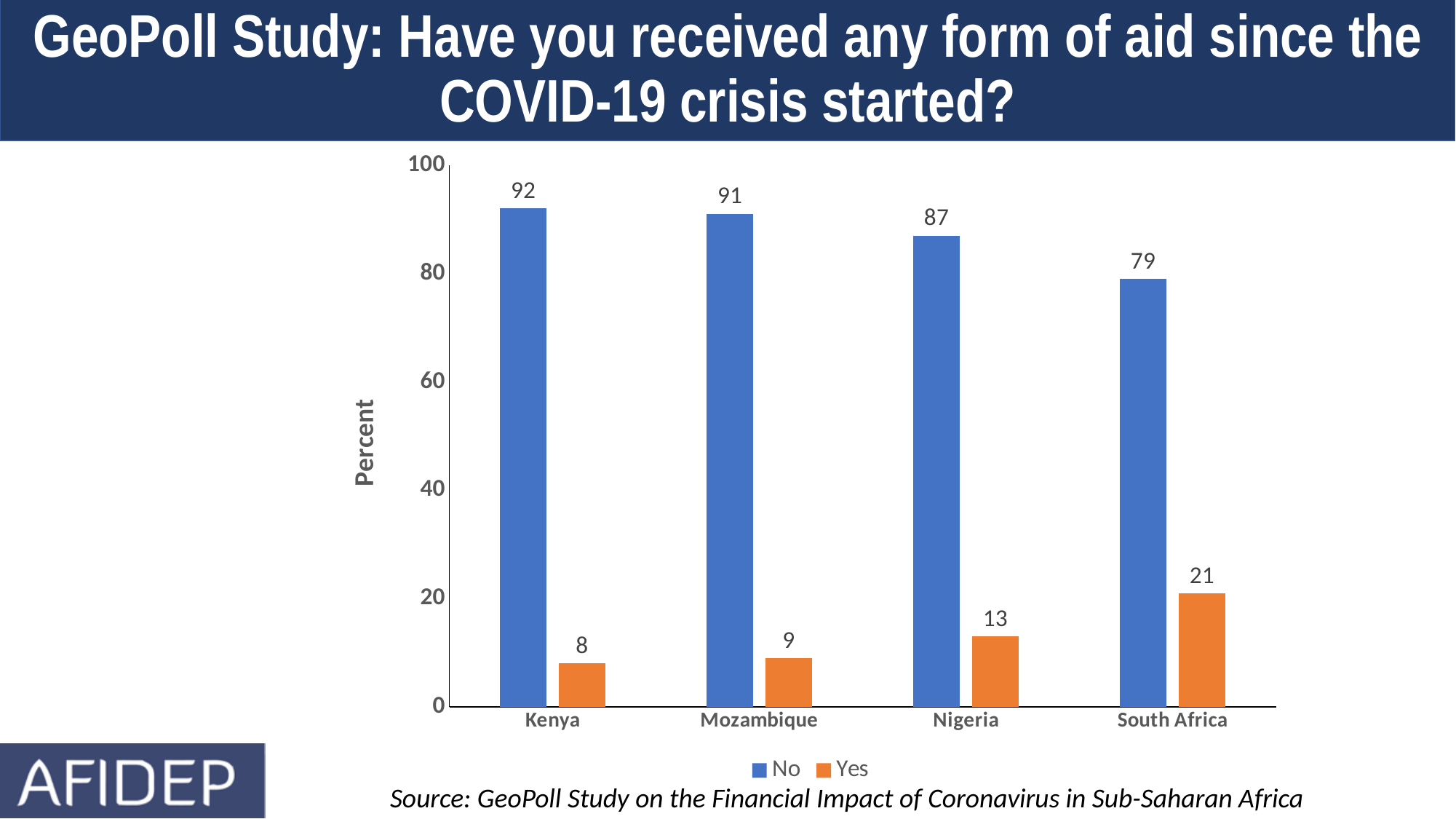
How many series does the legend list? 2 Which country has the highest No value? Kenya What percentage of respondents in Kenya answered No? 92 What is the Yes value for Nigeria? 13 How many countries are shown on the x axis? 4 Is the No value for South Africa greater or less than 80? less What is the label of the y axis? Percent What is the difference between the No and Yes values for South Africa? 58 Which is larger: the Yes value for Mozambique or the Yes value for Nigeria? Nigeria What percentage of respondents in South Africa answered Yes? 21 Which country has the lowest Yes value? Kenya What kind of chart is shown on the slide? Bar chart